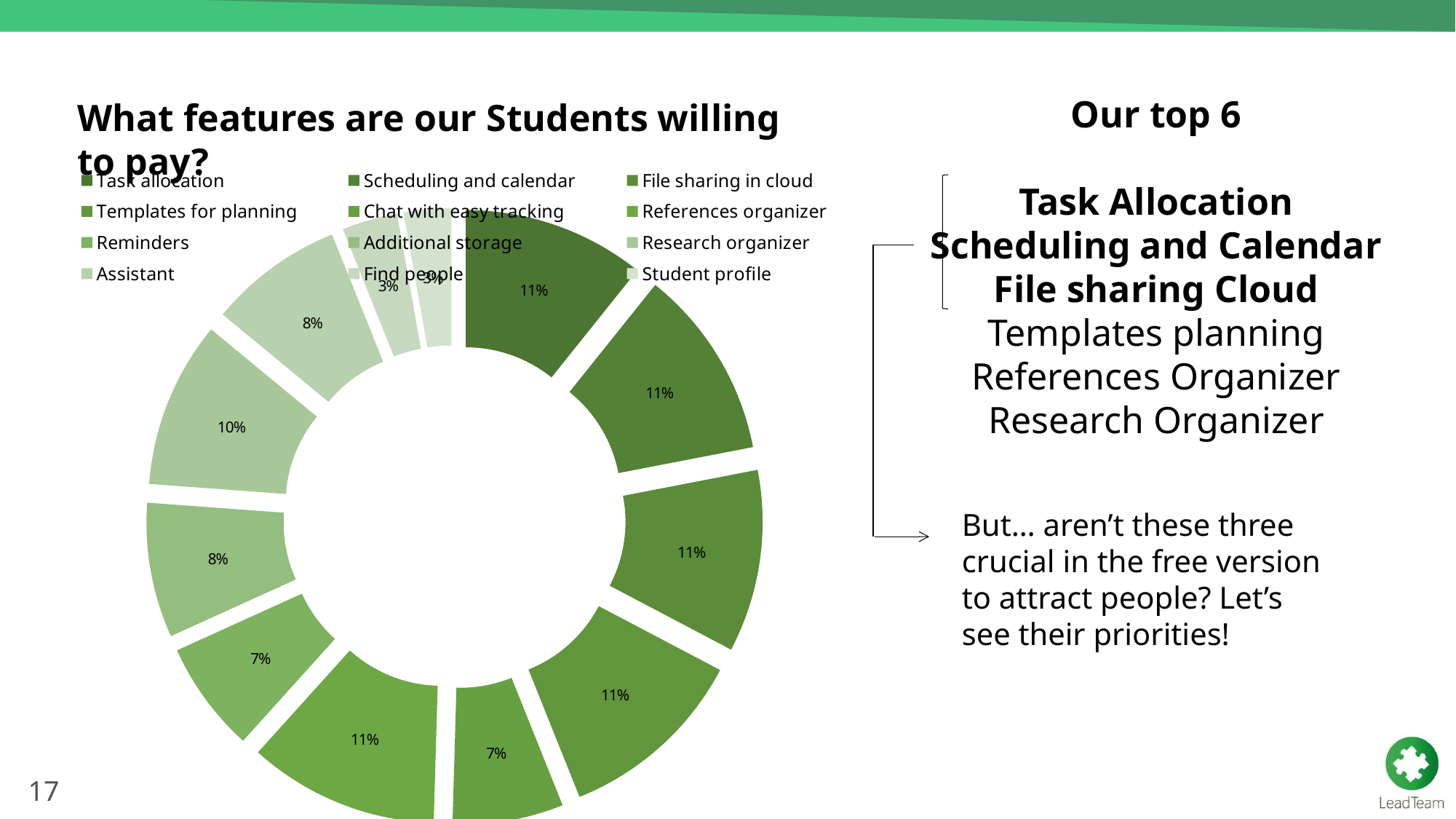
What share of the chart does Student profile represent? 3% What is the difference in percentage points between Research organizer (10%) and Student profile (3%)? 7 percentage points What is the title of the chart? What features are our Students willing to pay? Which is larger, the share for Task allocation or the share for Research organizer? Task allocation What share of the chart does Research organizer represent? 10% What share of the chart does Find people represent? 3% Which is larger, the share for Research organizer or the share for Find people? Research organizer What kind of chart is shown on the slide? Doughnut (pie) chart What share of the chart does Scheduling and calendar represent? 11% What is the difference in percentage points between Task allocation (11%) and Research organizer (10%)? 1 percentage point How many categories does the chart's legend list? 12 What share of the chart does Task allocation represent? 11%